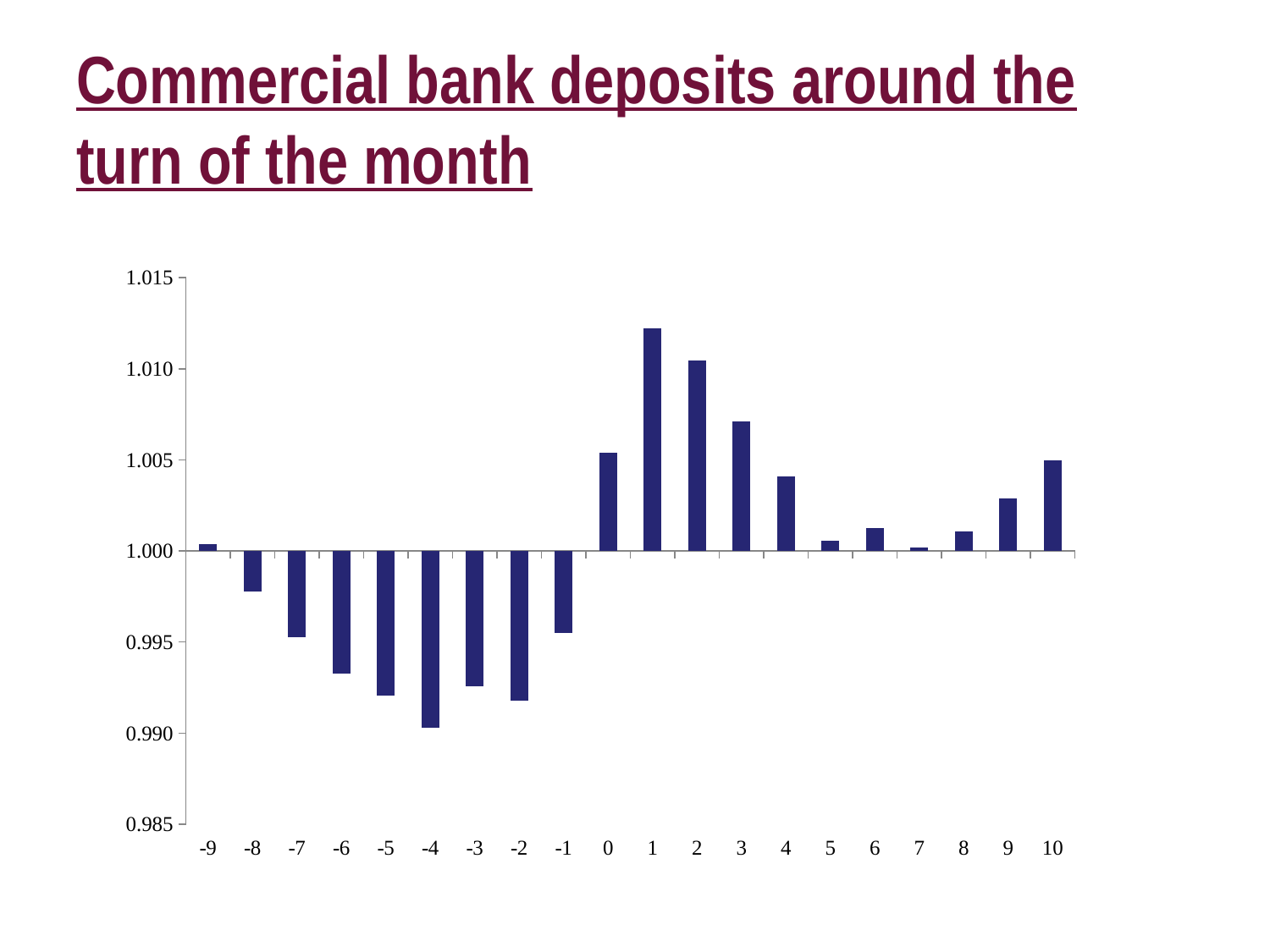
Which is larger, the value for category 8 or the value for category 9? 9 Is the value for category 3 greater or less than 1.005? greater Is the value for category -4 greater or less than 0.995? less Which category has the highest value? 1 Is the value for category 1 greater or less than 1.010? greater Which is larger, the value for category 1 or the value for category 2? 1 Which category has the lowest value? -4 What kind of chart is shown on the slide? bar chart What is the title of the slide? Commercial bank deposits around the turn of the month Do the values rise or fall from category 1 to category 5? fall How many categories are shown on the x axis? 20